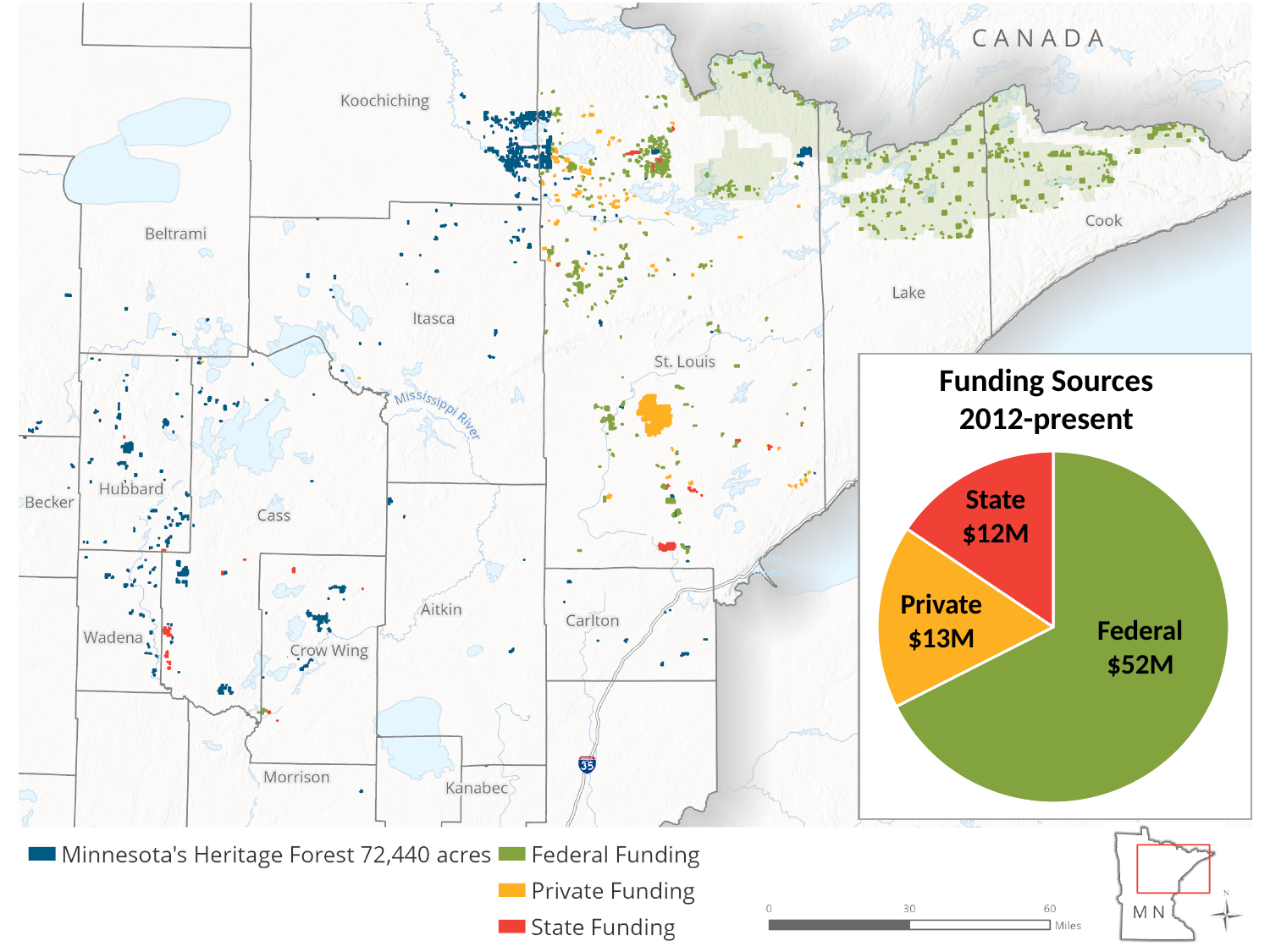
In the Funding Sources 2012-present pie chart, how much funding came from Private sources? $13M In the Funding Sources 2012-present pie chart, which is larger, Federal funding or State funding? Federal In the Funding Sources 2012-present pie chart, which funding source is the smallest? State What is the total funding shown across all three slices of the Funding Sources 2012-present pie chart? $77M How many slices does the Funding Sources 2012-present pie chart have? 3 In the Funding Sources 2012-present pie chart, which funding source is the largest? Federal In the Funding Sources 2012-present pie chart, what colour is the Federal slice? Green In the Funding Sources 2012-present pie chart, what is the difference between Private and State funding? $1M What kind of chart is the Funding Sources 2012-present chart? Pie chart In the Funding Sources 2012-present pie chart, how much funding came from State sources? $12M In the Funding Sources 2012-present pie chart, how much more Federal funding is there than Private funding? $39M In the Funding Sources 2012-present pie chart, how much funding came from Federal sources? $52M